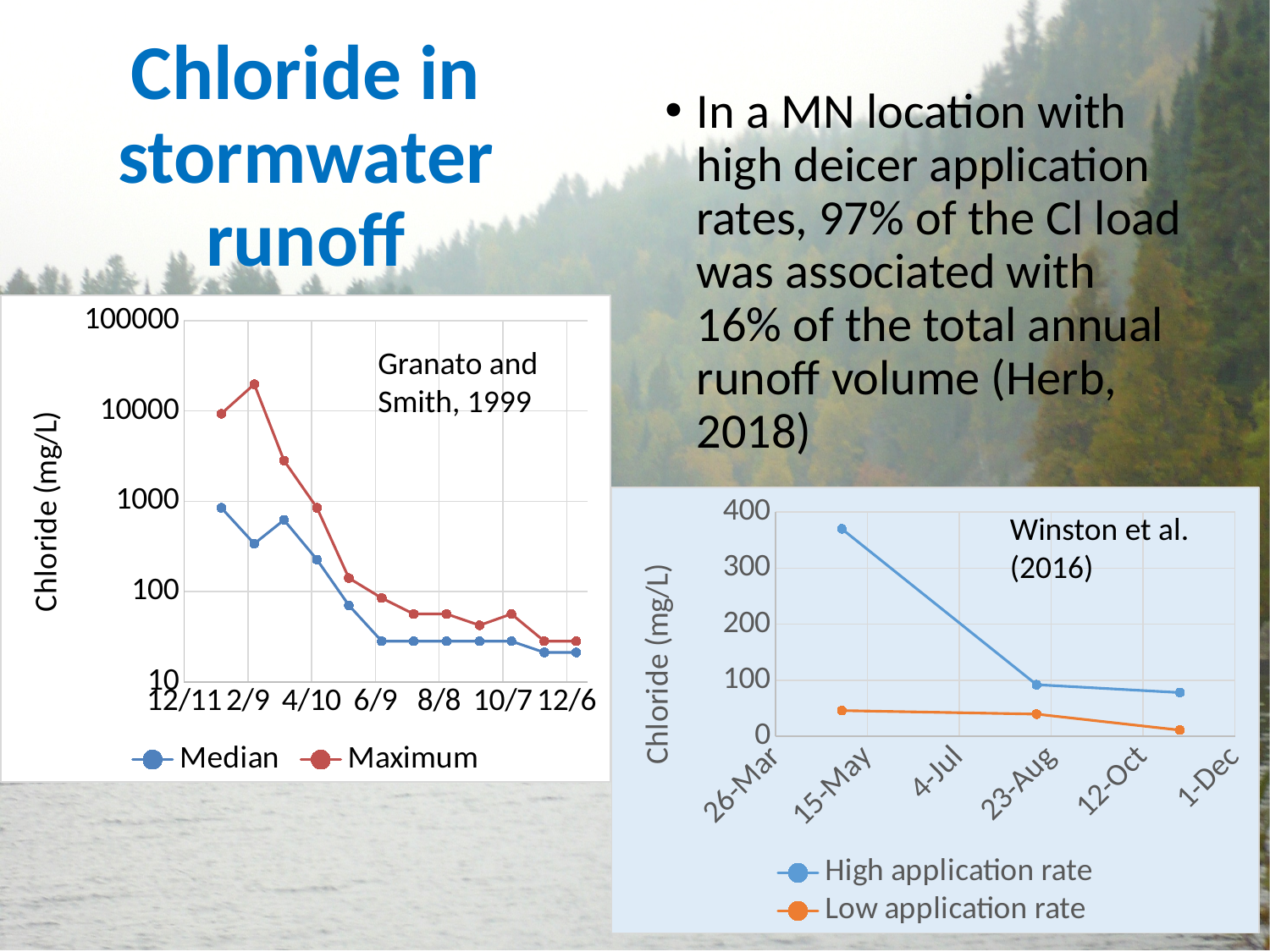
In the right chart (Winston et al. 2016), do the High application rate values rise or fall over time? fall In the left chart (Granato and Smith, 1999), do the Maximum values generally rise or fall from 2/9 to 12/6? fall What type of chart is the left chart (Granato and Smith, 1999)? line chart In the right chart (Winston et al. 2016), is the first High application rate value greater or less than 300? greater How many series does the legend of the left chart (Granato and Smith, 1999) list? 2 In the left chart (Granato and Smith, 1999), which series has the higher value at 2/9, Median or Maximum? Maximum How many data points does the High application rate series have in the right chart (Winston et al. 2016)? 3 What is the y-axis label of the left chart (Granato and Smith, 1999)? Chloride (mg/L) In the left chart (Granato and Smith, 1999), is the Maximum value at 2/9 greater or less than 10000? greater In the right chart (Winston et al. 2016), which series has the higher values, High application rate or Low application rate? High application rate How many series does the legend of the right chart (Winston et al. 2016) list? 2